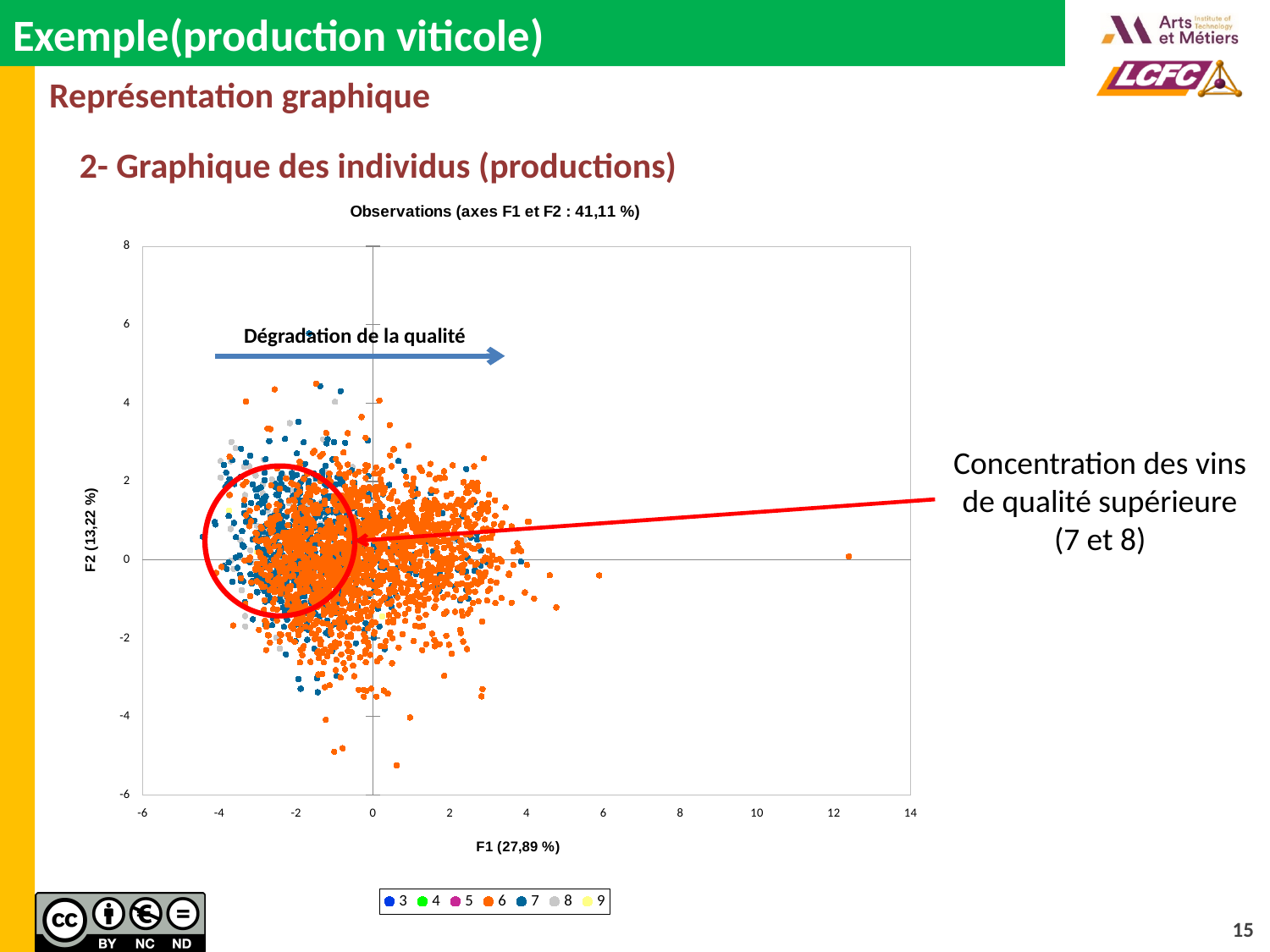
What is the minimum value shown on the vertical axis of the chart? -6 What is the maximum value shown on the horizontal axis of the chart? 14 How many series does the chart legend list? 7 What is the title of the chart? Observations (axes F1 et F2 : 41,11 %) What is the label of the vertical axis of the chart? F2 (13,22 %) Is the F2 value of the lowest point on the chart greater or less than -4? less What percentage of variance does axis F1 explain according to the axis label? 27,89 % What kind of chart is shown on the slide? scatter plot Which legend entry is listed first in the chart legend? 3 Which legend entry is listed last in the chart legend? 9 What is the label of the horizontal axis of the chart? F1 (27,89 %) Is the F1 value of the isolated point furthest to the right greater or less than 10? greater